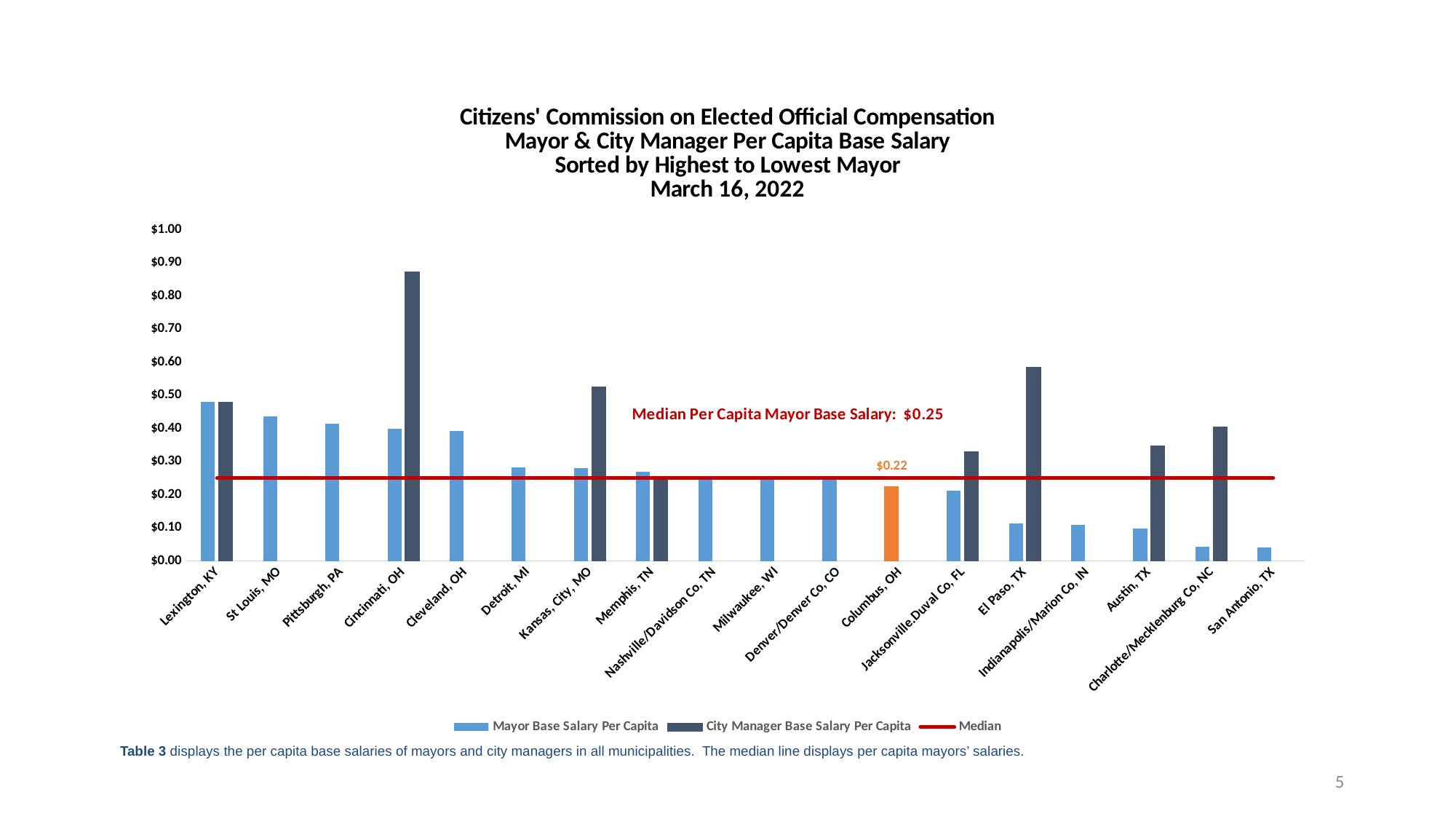
What is the Mayor Base Salary Per Capita for Columbus, OH? $0.22 How many municipalities are shown on the x axis of the chart? 18 What type of chart is shown on the slide? bar chart What is the median per capita mayor base salary shown on the chart? $0.25 By how much is the Columbus, OH mayor per capita base salary below the median of $0.25? $0.03 Is the Mayor Base Salary Per Capita for San Antonio, TX greater or less than $0.10? less Which municipality has the highest Mayor Base Salary Per Capita? Lexington, KY How many entries does the chart's legend list? 3 Do the Mayor Base Salary Per Capita bars rise or fall from left to right across the x axis? fall For Cincinnati, OH, which is larger: the Mayor Base Salary Per Capita or the City Manager Base Salary Per Capita? City Manager Base Salary Per Capita Which municipality has the highest City Manager Base Salary Per Capita? Cincinnati, OH Is the City Manager Base Salary Per Capita for Cincinnati, OH greater or less than $0.80? greater